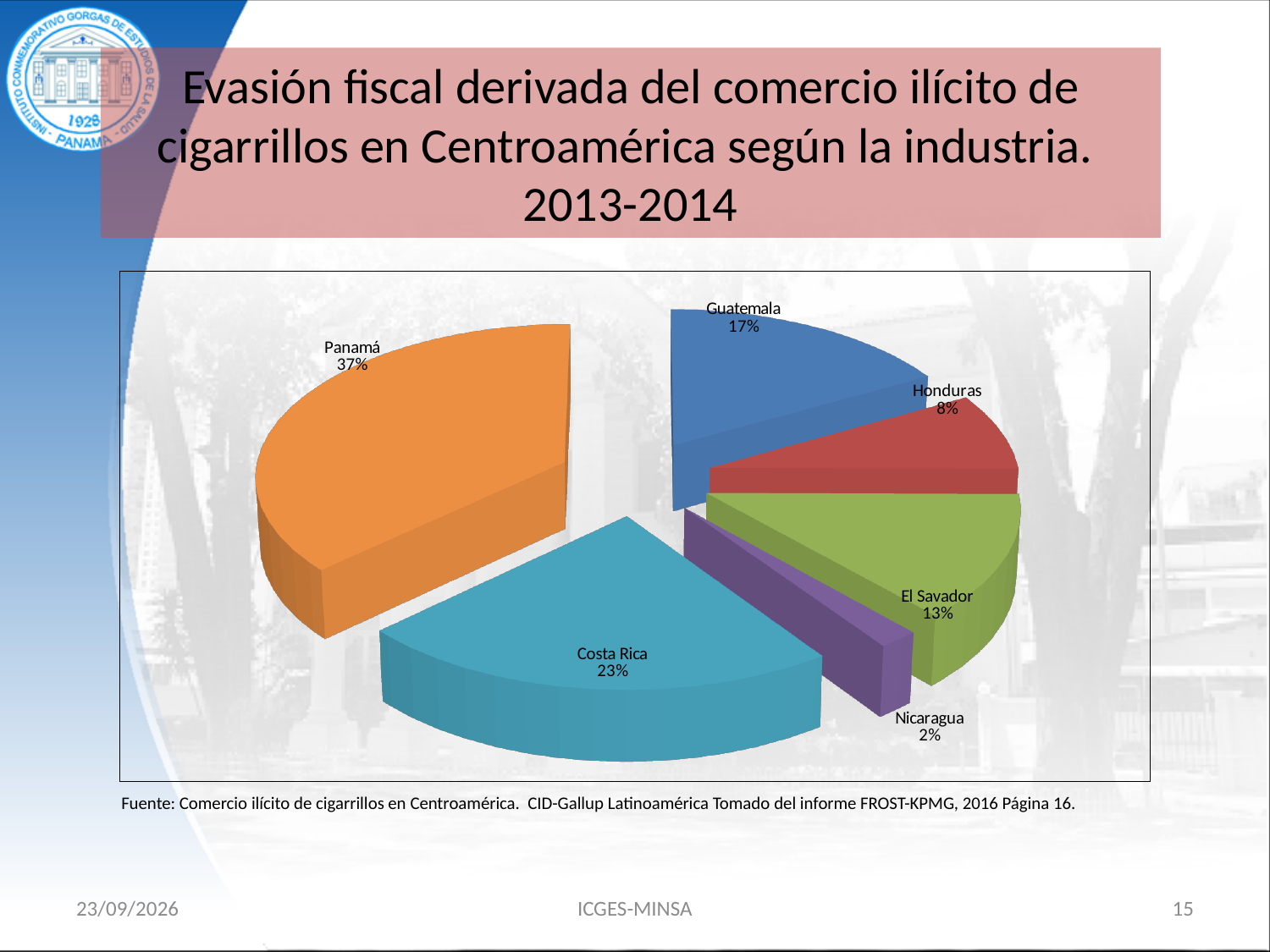
What share of the pie does Panamá hold? 37% Which is larger, the share for Guatemala or the share for El Savador? Guatemala What is the value shown for Costa Rica? 23% Which country has the largest slice of the pie? Panamá What is the difference in percentage points between Panamá and Costa Rica? 14 What is the value shown for Guatemala? 17% What is the value shown for Honduras? 8% How many countries are shown in the pie chart? 6 What kind of chart is shown on the slide? Pie chart What colour is the slice for Costa Rica? Teal (light blue) What is the value shown for Nicaragua? 2% Which country has the smallest slice of the pie? Nicaragua